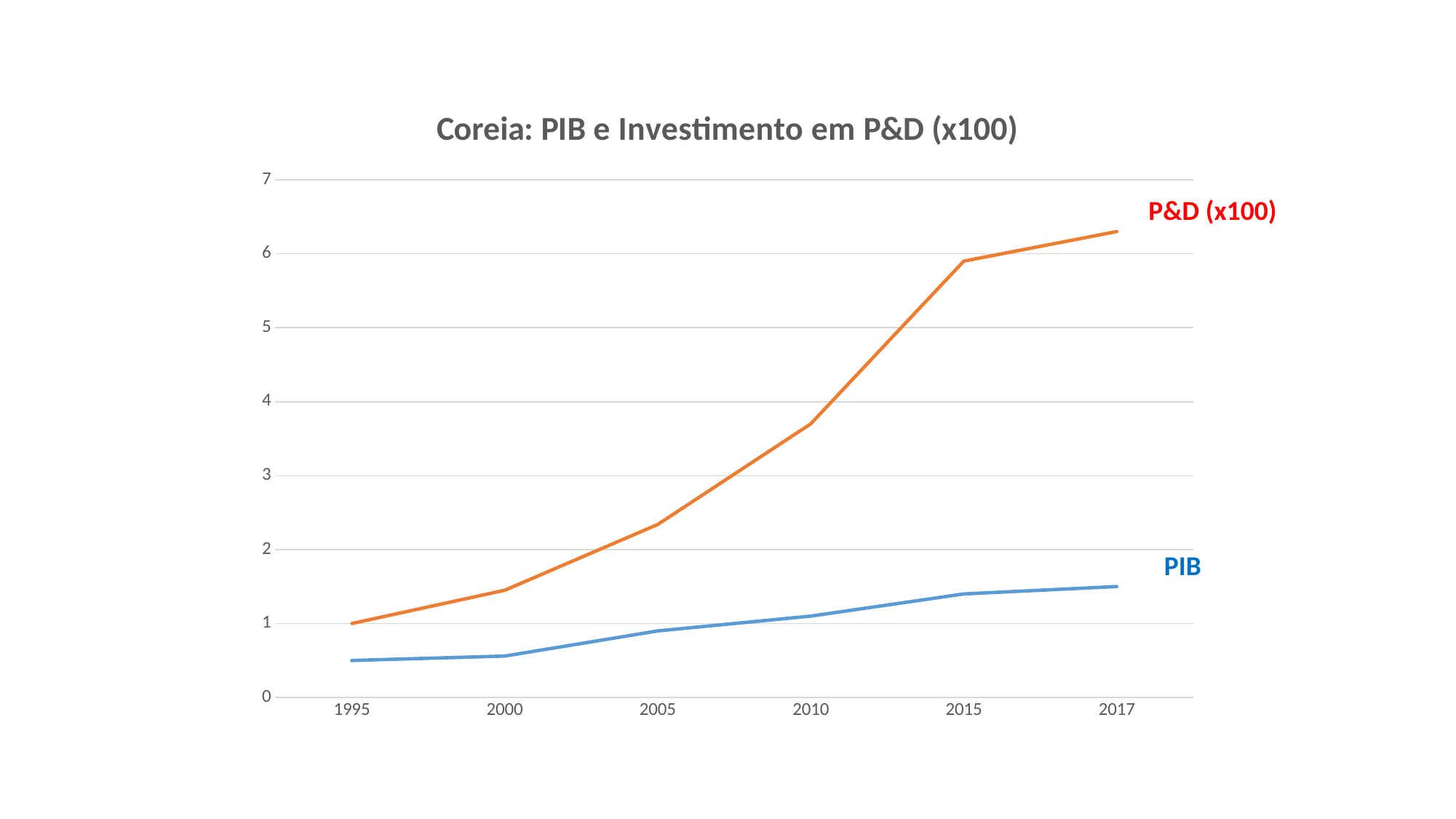
In which year does P&D (x100) reach its highest value? 2017 Is the value for PIB in 2000 greater or less than 1? less How many years are shown on the x axis? 6 What type of chart is shown on the slide? line chart Is the value for P&D (x100) in 2010 greater or less than 4? less Which series has the higher value in 2017, P&D (x100) or PIB? P&D (x100) Is the value for P&D (x100) in 2017 greater or less than 6? greater How many series are plotted in the chart? 2 Does the PIB line rise or fall from 1995 to 2017? rise What is the value of P&D (x100) in 1995? 1 What is the title of the chart? Coreia: PIB e Investimento em P&D (x100)